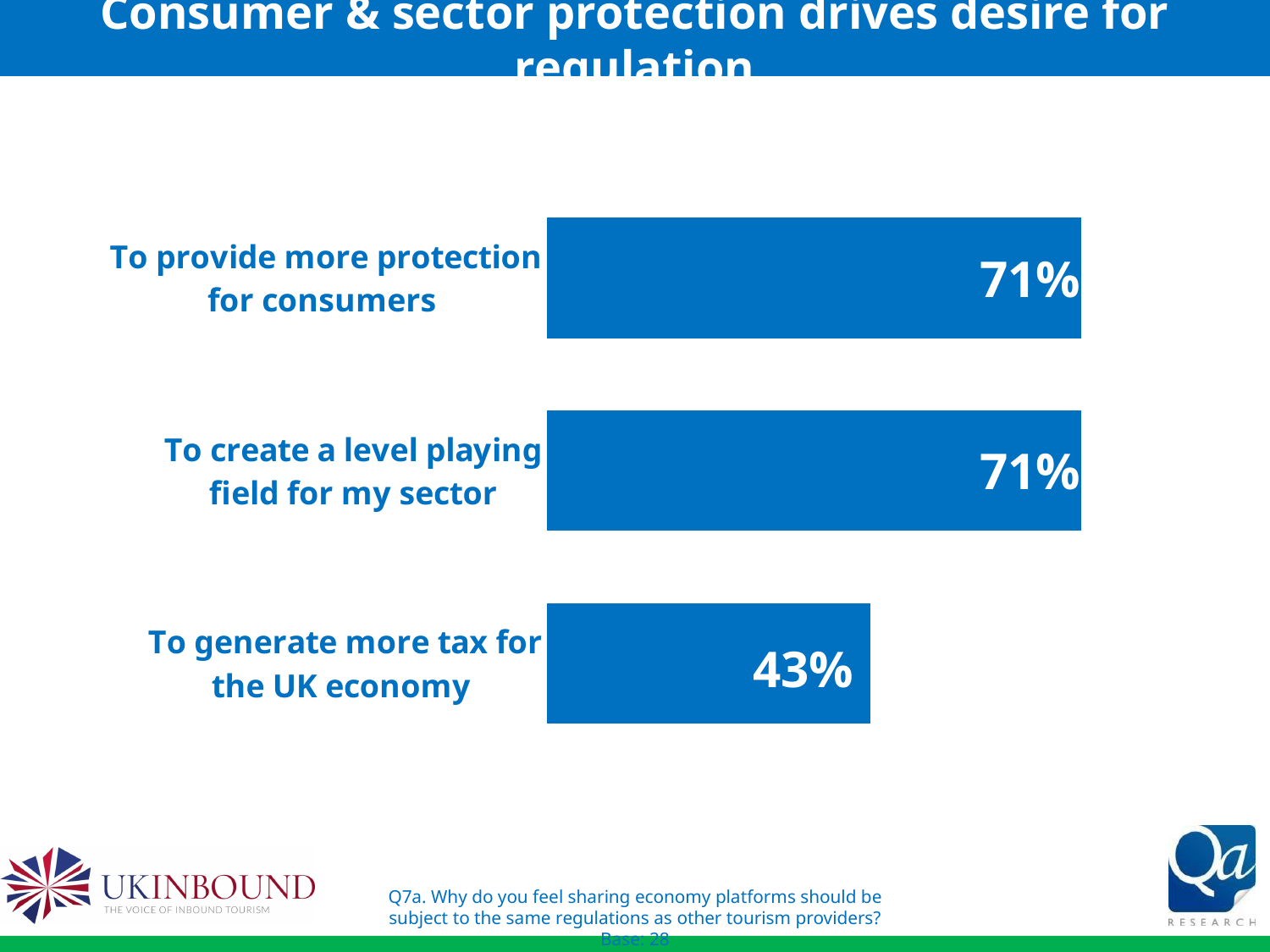
What percentage is shown for "To provide more protection for consumers"? 71% What kind of chart is shown on the slide? Bar chart Do the two top reasons have the same percentage? Yes Which reason has the lowest percentage? To generate more tax for the UK economy What is the title of the slide? Consumer & sector protection drives desire for regulation What is the difference between the percentage for "To create a level playing field for my sector" and "To generate more tax for the UK economy"? 28% How many reasons (categories) are shown in the chart? 3 What percentage is shown for "To generate more tax for the UK economy"? 43% Which is larger: the value for "To provide more protection for consumers" or the value for "To generate more tax for the UK economy"? To provide more protection for consumers What is the base (number of respondents) stated on the slide? 28 What percentage is shown for "To create a level playing field for my sector"? 71%